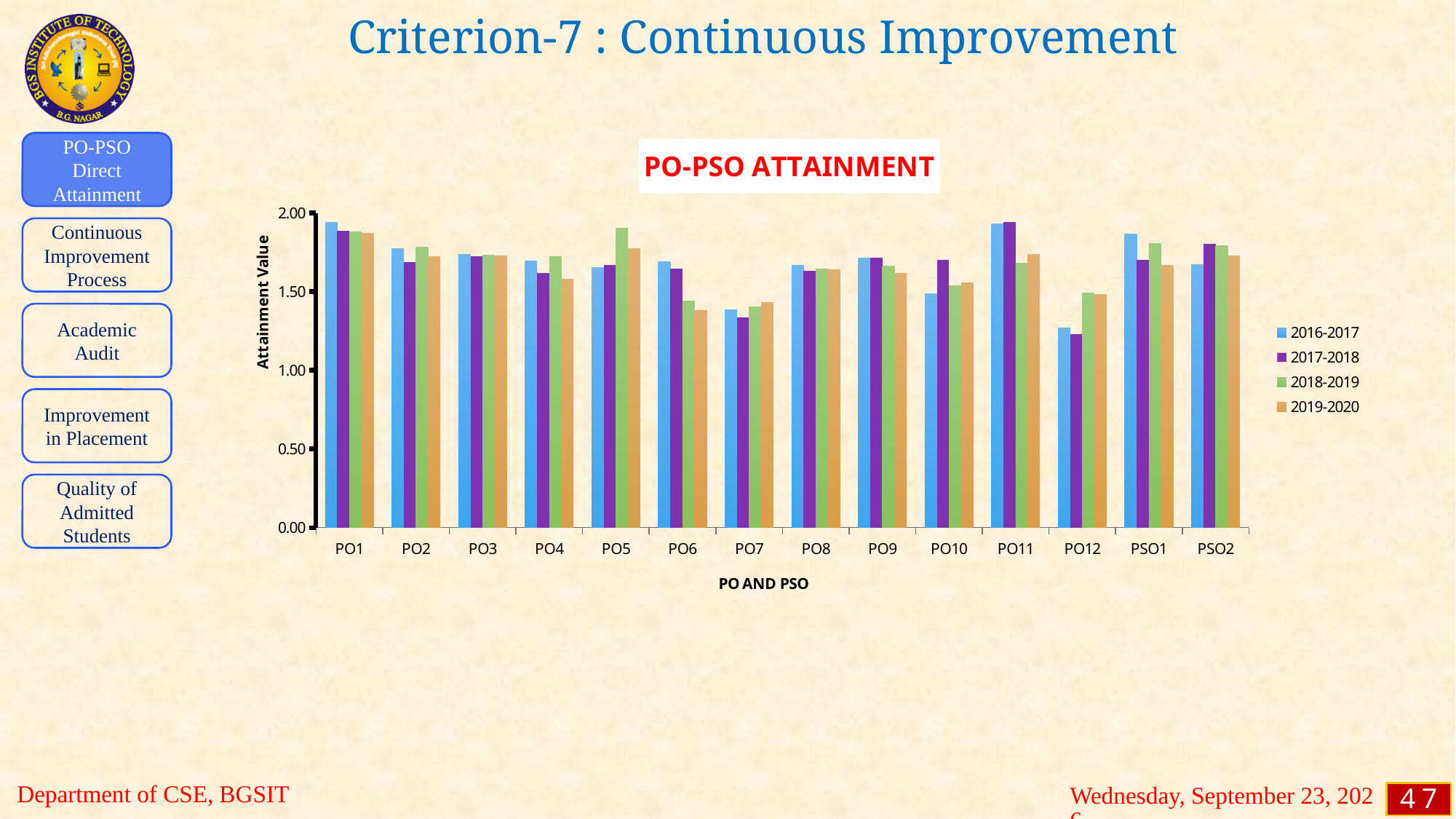
What is the title of the chart? PO-PSO ATTAINMENT For PO5, which series has the larger value: 2016-2017 or 2018-2019? 2018-2019 For the 2017-2018 series, which category has the lowest attainment value? PO12 Is the 2017-2018 value for PO7 greater or less than 1.50? less How many categories are shown along the x axis of the PO-PSO ATTAINMENT chart? 14 How many series does the legend of the PO-PSO ATTAINMENT chart list? 4 What kind of chart is shown on the slide? bar chart Is the 2016-2017 value for PO1 greater or less than 1.50? greater For the 2018-2019 series, which category has the highest attainment value? PO5 What is the label on the vertical axis of the chart? Attainment Value For PO6, which series has the larger value: 2016-2017 or 2019-2020? 2016-2017 Is the 2016-2017 value for PO12 greater or less than 1.50? less